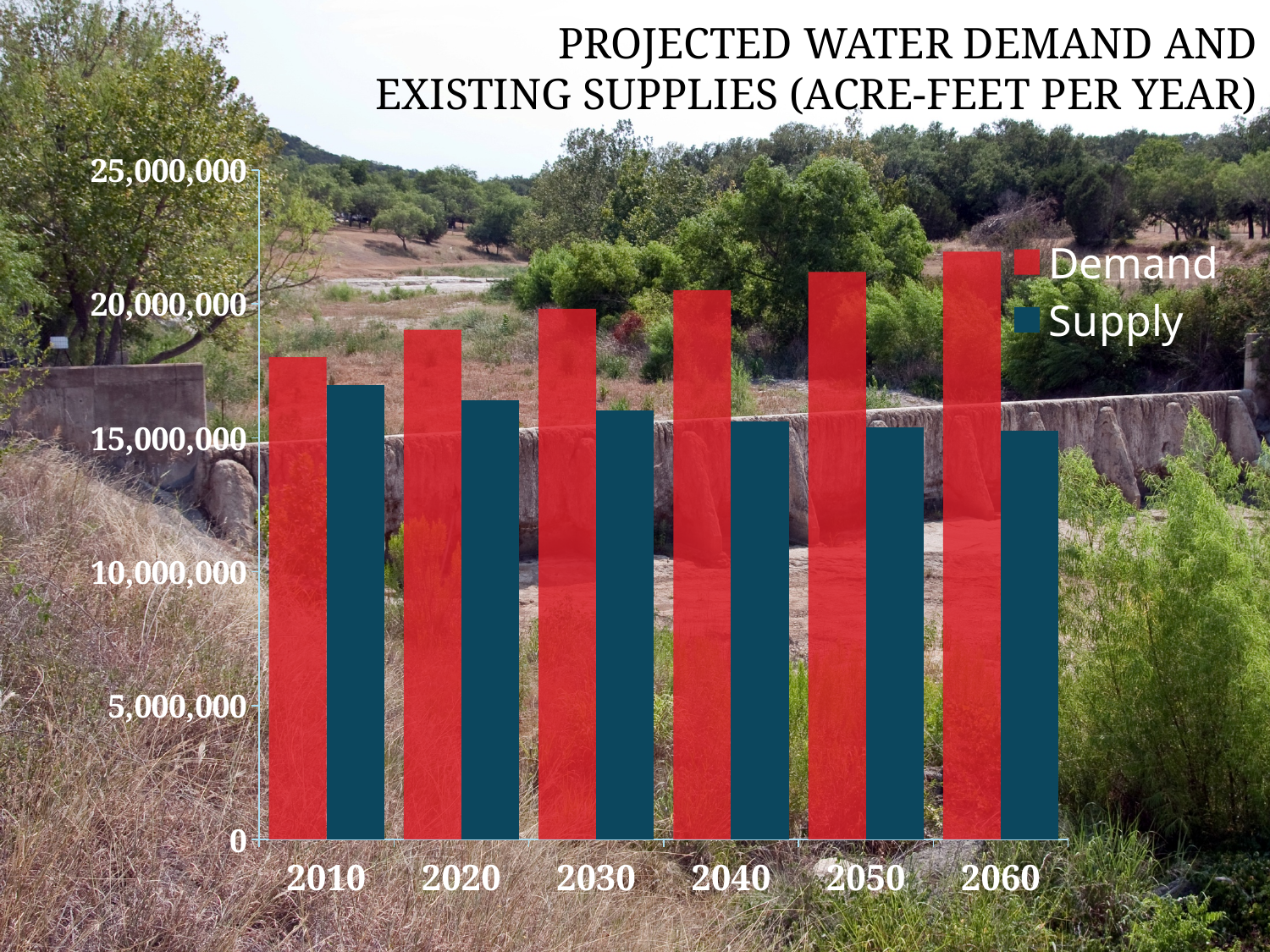
What kind of chart is shown on the slide? bar chart Which colour represents Supply in the legend? dark blue In which year is Demand lowest? 2010 In which year is Demand highest? 2060 Is the Demand value for 2050 greater or less than 20,000,000? greater Is the Supply value for 2010 greater or less than 15,000,000? greater Do the Demand values rise or fall from 2010 to 2060? rise In 2060, which is larger, Demand or Supply? Demand How many series does the legend list? 2 How many years are shown on the x axis? 6 In which year is Supply highest? 2010 Do the Supply values rise or fall from 2010 to 2060? fall